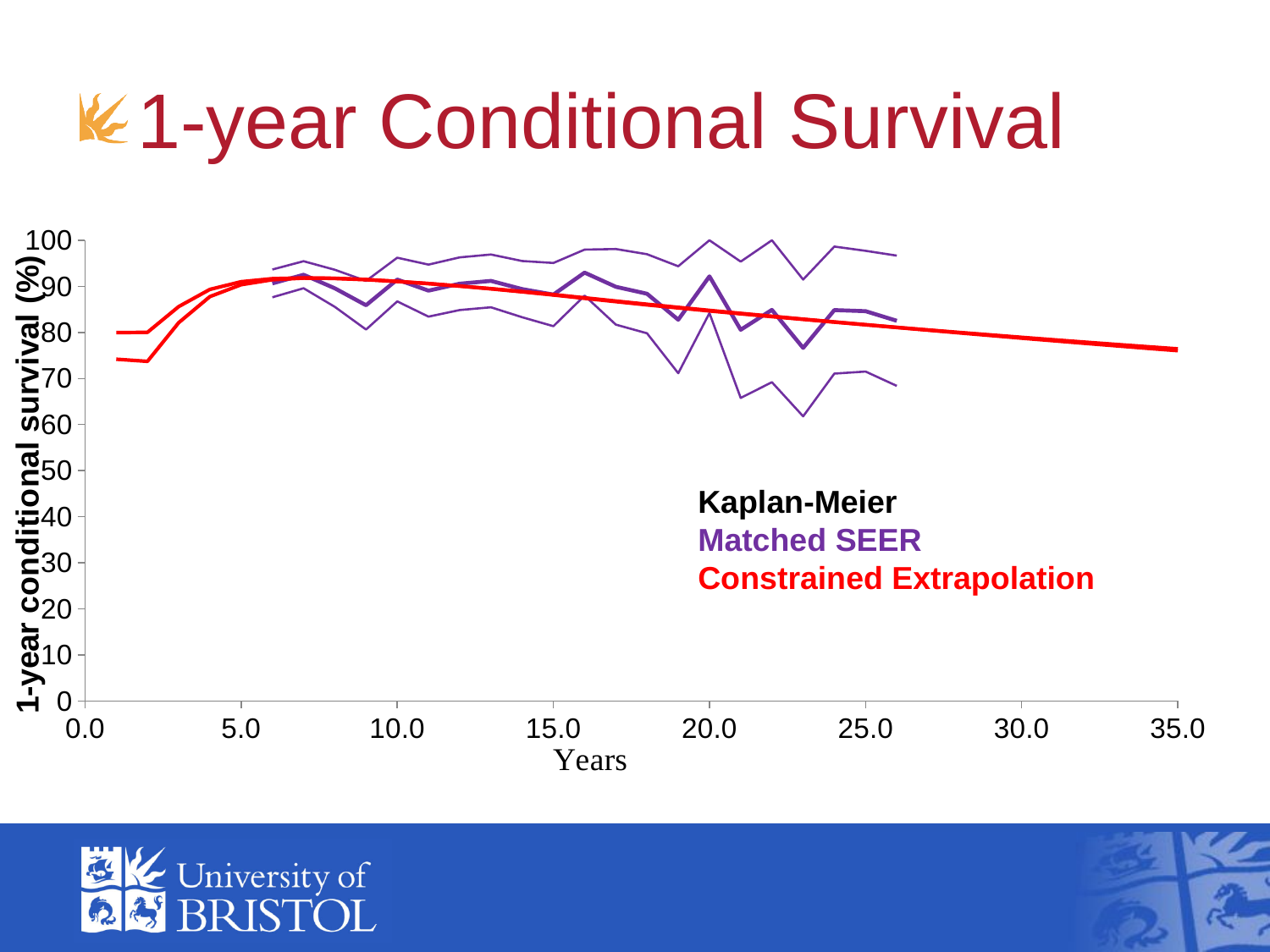
Is the value of the Constrained Extrapolation line at 35.0 years greater or less than 80? less What kind of chart is shown on the slide? line chart How many tick labels are shown on the x axis? 8 Is the value of the Constrained Extrapolation line at 10.0 years greater or less than 80? greater Does the Constrained Extrapolation line rise or fall between 10.0 and 35.0 years? fall What is the title of the slide's chart? 1-year Conditional Survival How many series does the legend list? 3 Is the lowest point of the Matched SEER lower band, near 23 years, greater or less than 70? less What is the label of the x axis? Years What is the highest value shown on the y axis? 100